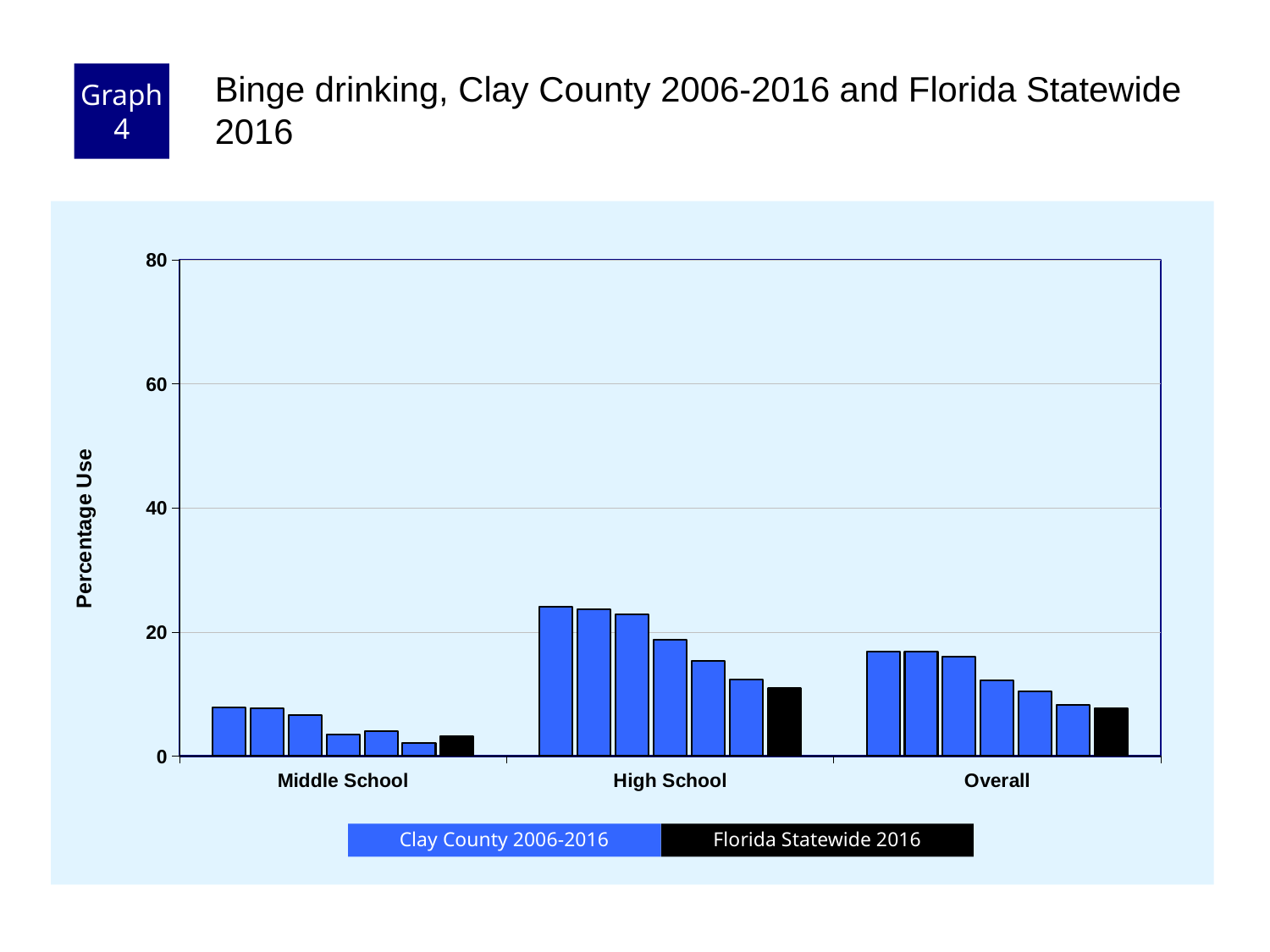
Which category has the shortest bars? Middle School Is the Florida Statewide 2016 value for Middle School greater or less than 20? less How many series does the legend list? 2 What colour are the Florida Statewide 2016 bars? black How many categories are shown on the x axis? 3 Which category has the tallest bars? High School Which is larger, the Florida Statewide 2016 value for High School or for Middle School? High School What kind of chart is shown on the slide? bar chart Is the Florida Statewide 2016 value for High School greater or less than 20? less Is the tallest Clay County bar for High School greater or less than 20? greater Within the High School group, do the Clay County 2006-2016 bars rise or fall from left to right? fall